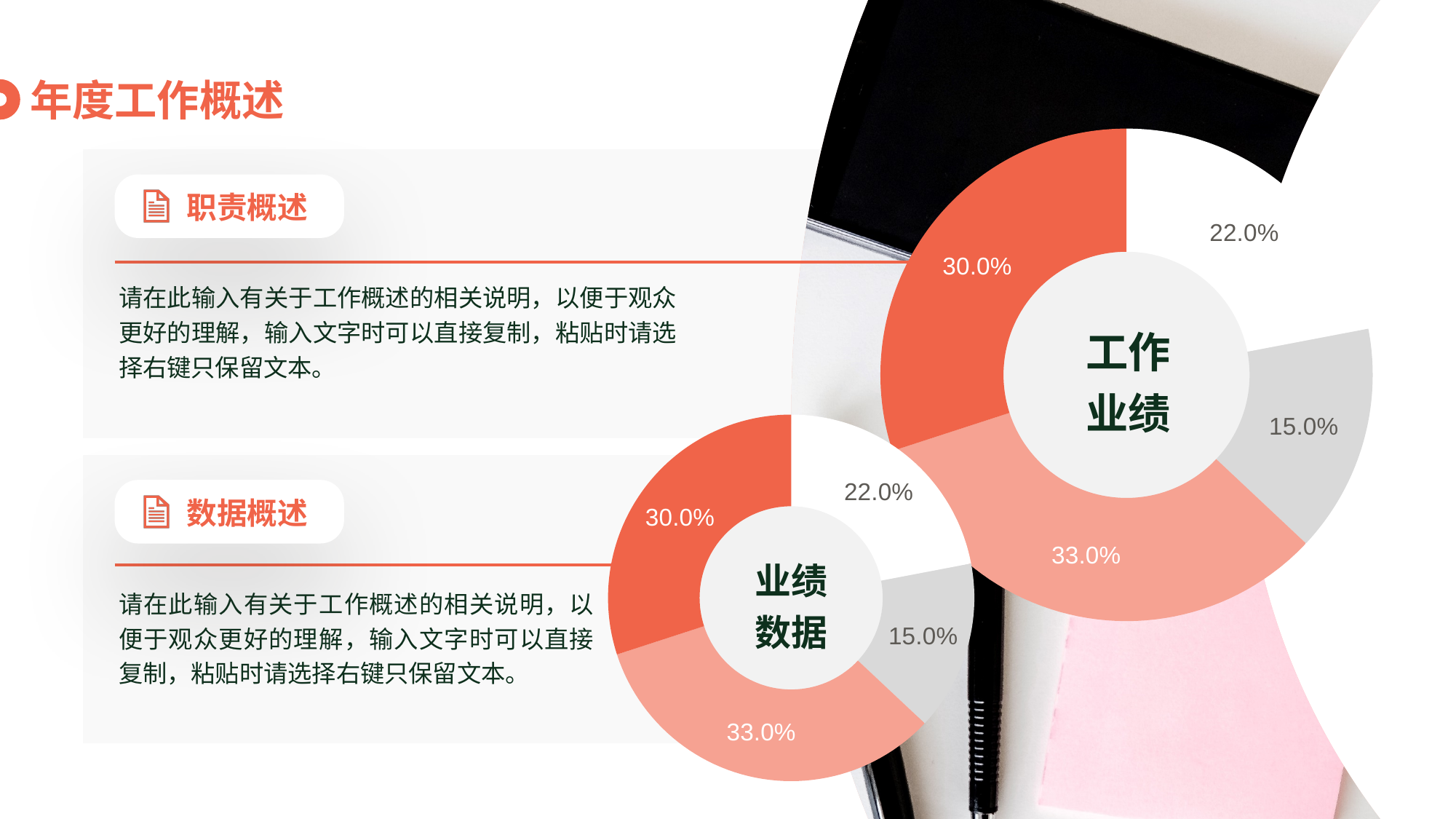
In the chart titled 工作业绩, is the value of the white slice greater or less than 25%? less In the chart titled 业绩数据, what is the smallest slice's value? 15.0% In the chart titled 业绩数据, what is the difference between the 30.0% slice and the 22.0% slice? 8.0% What is the sum of all four slice values in the chart titled 业绩数据? 100.0% How many slices does the chart titled 业绩数据 have? 4 In the chart titled 业绩数据, which is larger: the orange-red slice or the white slice? the orange-red slice (30.0%) What kind of chart is the chart titled 工作业绩? doughnut (pie) chart In the chart titled 工作业绩, what value is shown on the grey slice? 15.0% How many doughnut charts are on the slide? 2 In the chart titled 工作业绩, what is the difference between the largest slice (33.0%) and the smallest slice (15.0%)? 18.0% In the chart titled 业绩数据, what value is shown on the salmon-pink slice? 33.0% In the chart titled 工作业绩, what is the largest slice's value? 33.0%